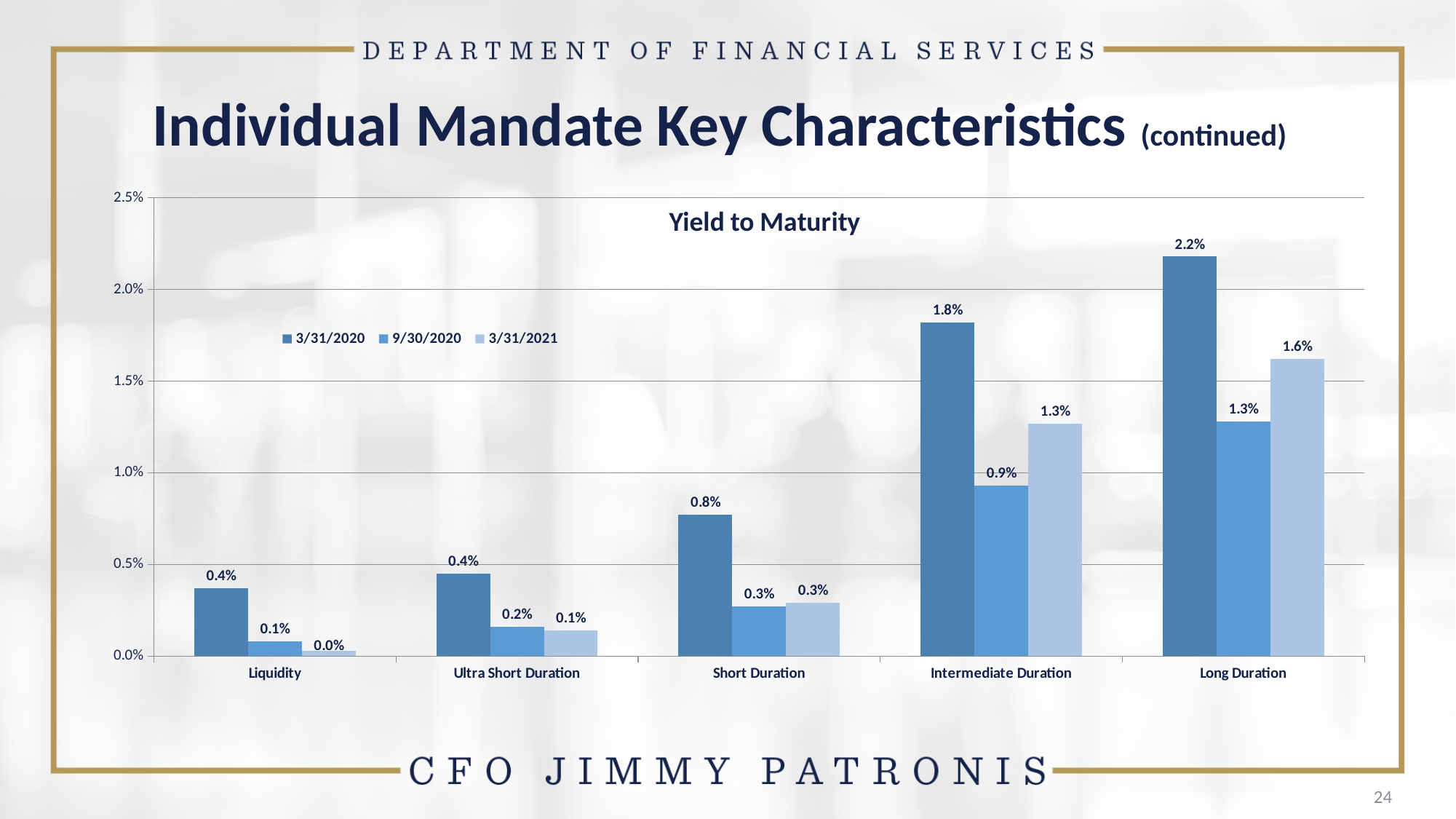
Is the 3/31/2020 value for Long Duration greater or less than 2.0%? greater What is the yield to maturity for Intermediate Duration as of 9/30/2020? 0.9% What is the yield to maturity for Long Duration as of 3/31/2020? 2.2% What is the yield to maturity for Liquidity as of 3/31/2021? 0.0% For Long Duration, what is the difference between the 3/31/2020 value and the 9/30/2020 value? 0.9% For Intermediate Duration, which is larger: the 9/30/2020 value or the 3/31/2021 value? 3/31/2021 What type of chart is shown on the slide? Bar chart How many categories are shown on the x axis? 5 How many series does the legend list? 3 Which category has the lowest yield to maturity for the 3/31/2020 series? Liquidity Which category has the highest yield to maturity for the 3/31/2021 series? Long Duration What is the title of the chart? Yield to Maturity